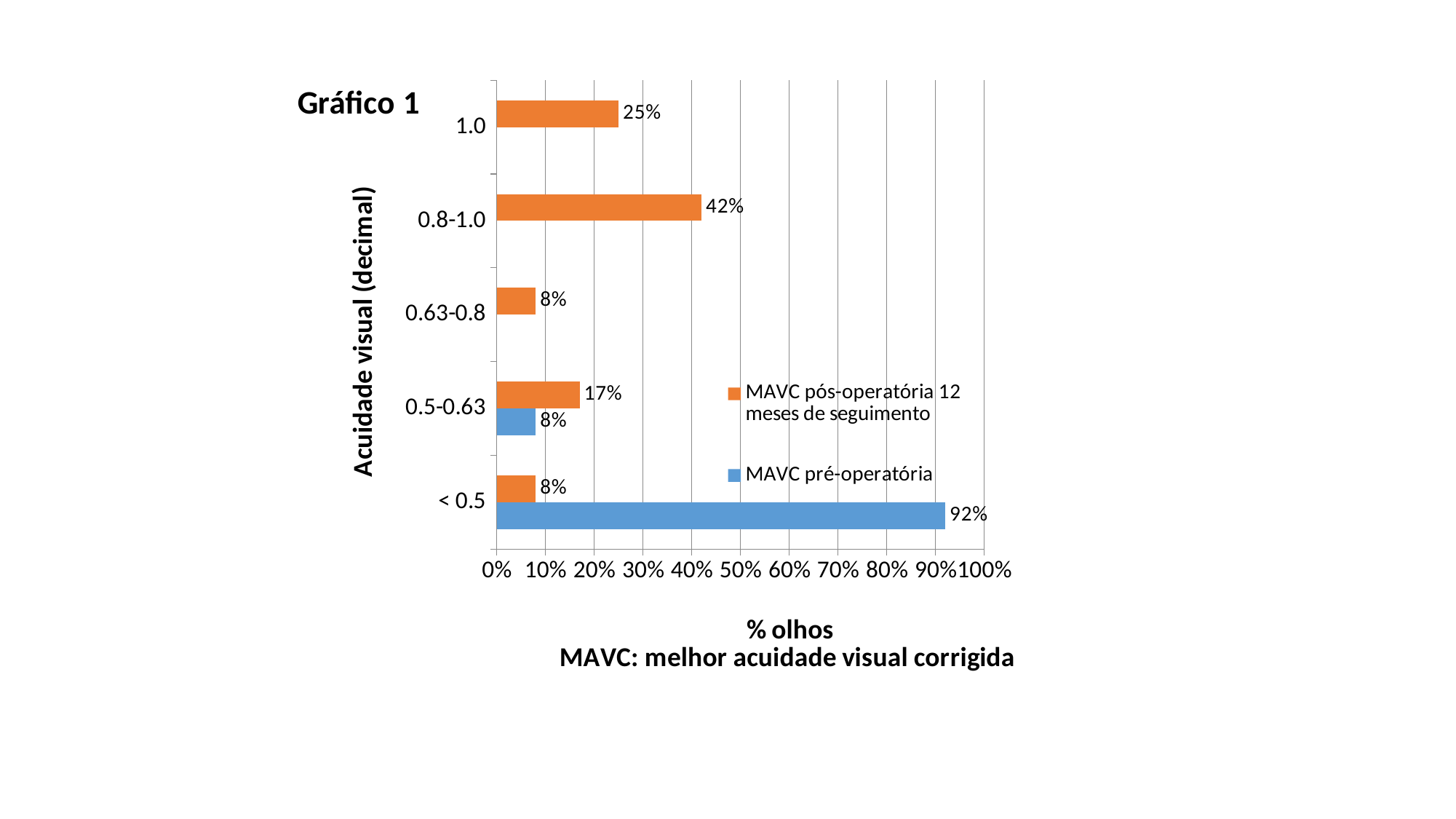
Which category has the highest value in the MAVC pós-operatória 12 meses de seguimento series? 0.8-1.0 What is the value for the < 0.5 category in the MAVC pré-operatória series? 92% What is the value for the 0.5-0.63 category in the MAVC pré-operatória series? 8% What is the value for the 1.0 category in the MAVC pós-operatória 12 meses de seguimento series? 25% Which category has the highest value in the MAVC pré-operatória series? < 0.5 What kind of chart is shown on the slide? Bar chart For the 0.5-0.63 category, which series has the larger value: MAVC pós-operatória 12 meses de seguimento or MAVC pré-operatória? MAVC pós-operatória 12 meses de seguimento What is the value for the 0.8-1.0 category in the MAVC pós-operatória 12 meses de seguimento series? 42% What is the title of the vertical axis of the chart? Acuidade visual (decimal) How many series does the legend list? 2 How many categories are shown on the vertical axis of the chart? 5 What is the difference between the MAVC pré-operatória and MAVC pós-operatória 12 meses de seguimento values for the < 0.5 category? 84%